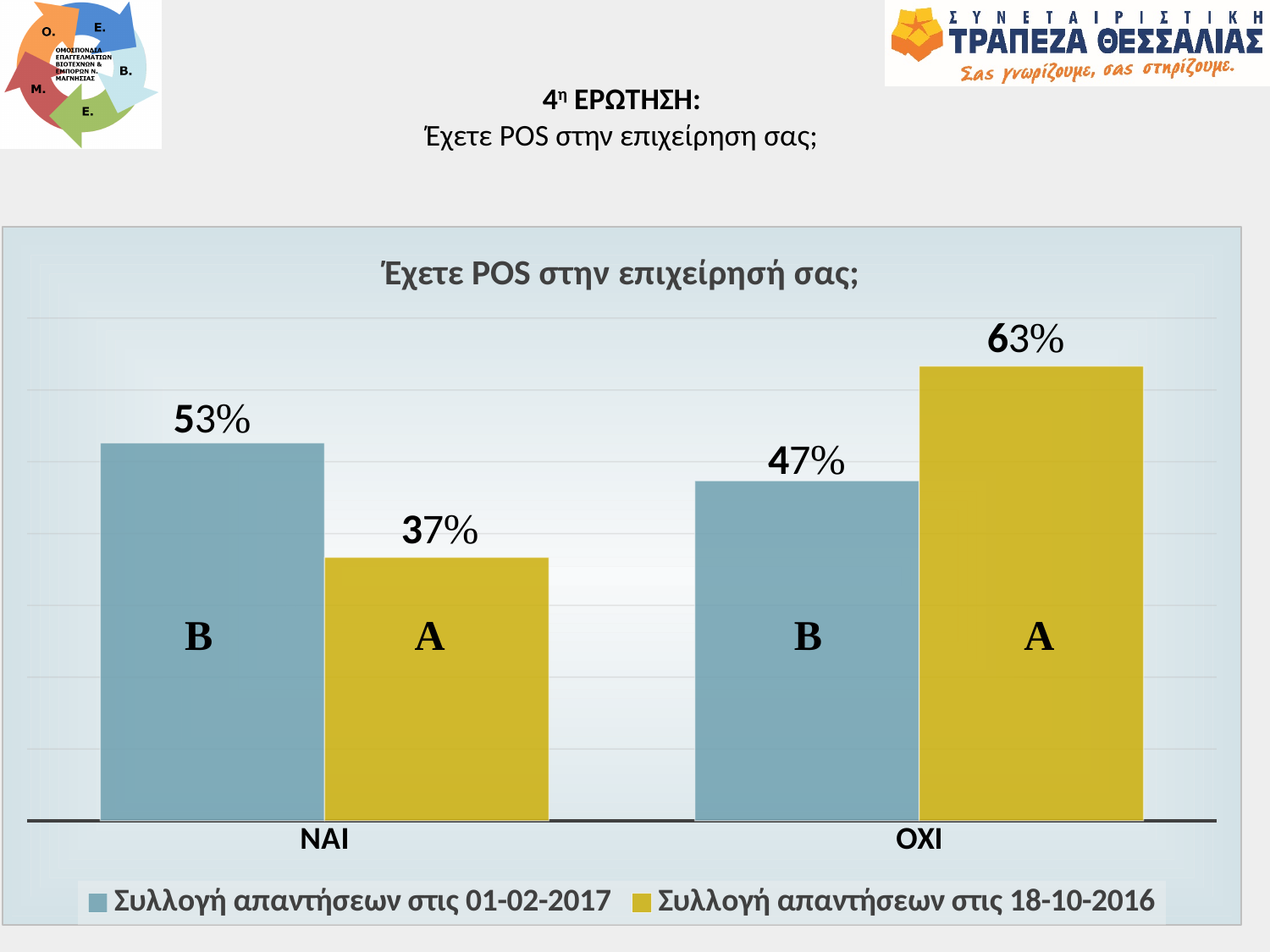
Which bar has the lowest value in the chart? ΝΑΙ, Συλλογή απαντήσεων στις 18-10-2016 How many categories are shown on the x axis? 2 How many series does the legend list? 2 What is the value for ΟΧΙ in the series Συλλογή απαντήσεων στις 18-10-2016? 63% What is the value for ΟΧΙ in the series Συλλογή απαντήσεων στις 01-02-2017? 47% What is the value for ΝΑΙ in the series Συλλογή απαντήσεων στις 18-10-2016? 37% For ΟΧΙ, which series has the larger value: Συλλογή απαντήσεων στις 01-02-2017 or Συλλογή απαντήσεων στις 18-10-2016? Συλλογή απαντήσεων στις 18-10-2016 What is the value for ΝΑΙ in the series Συλλογή απαντήσεων στις 01-02-2017? 53% What is the difference between the ΝΑΙ values of the two series? 16% What kind of chart is shown on the slide? Bar chart What is the difference between the ΟΧΙ values of the two series? 16% Which bar has the highest value in the chart? ΟΧΙ, Συλλογή απαντήσεων στις 18-10-2016